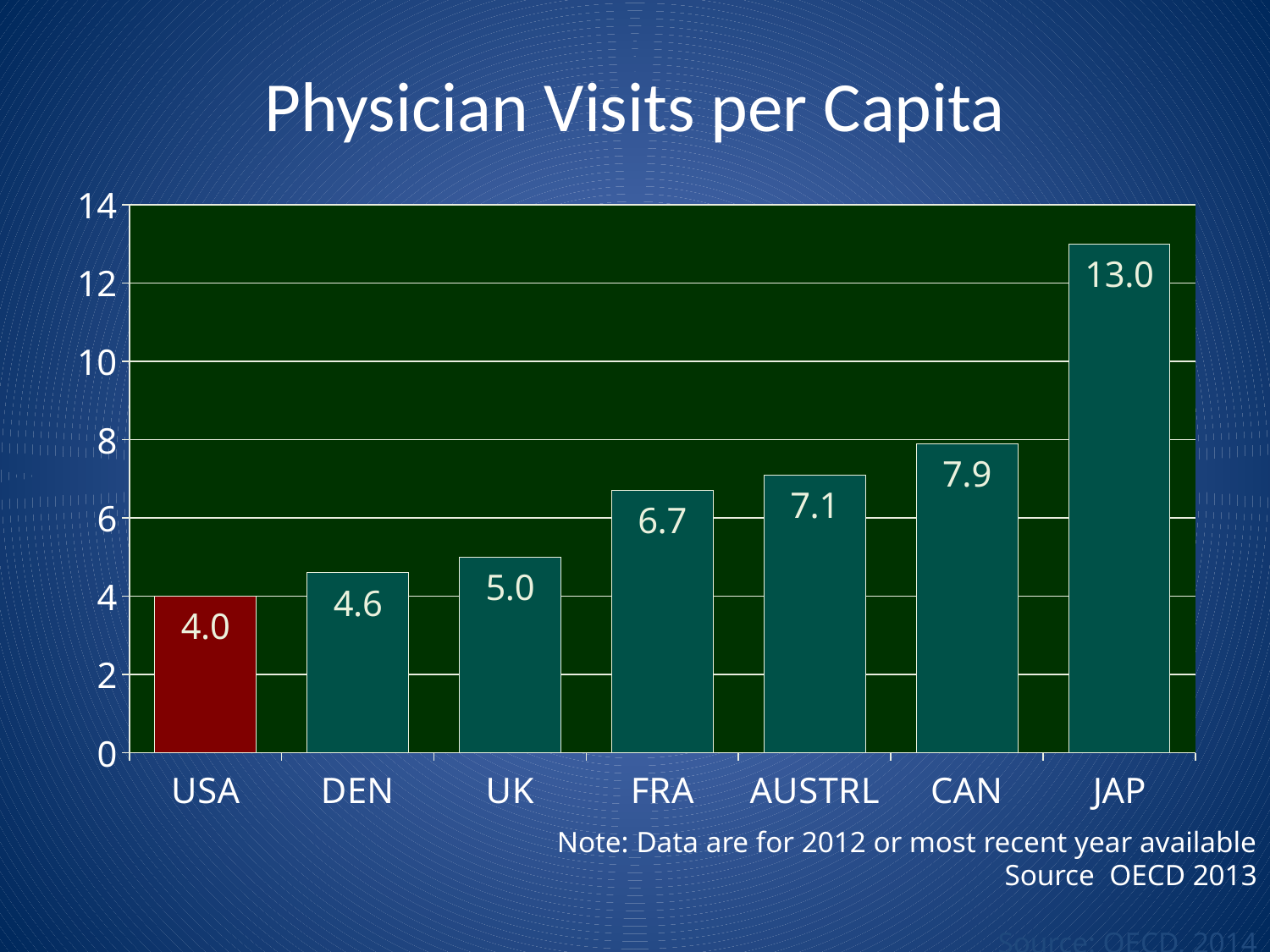
Which country has the lowest physician visits per capita? USA Which is larger, the value for DEN or the value for UK? UK Which bar is coloured differently from the others? USA What is the difference between the values for CAN and FRA? 1.2 How many countries are shown on the chart? 7 What kind of chart is this? bar chart What is the value for AUSTRL? 7.1 What is the difference between the values for JAP and USA? 9.0 What is the value for USA? 4.0 Which country has the highest physician visits per capita? JAP What is the value for JAP? 13.0 Is the value for CAN greater or less than 8? less